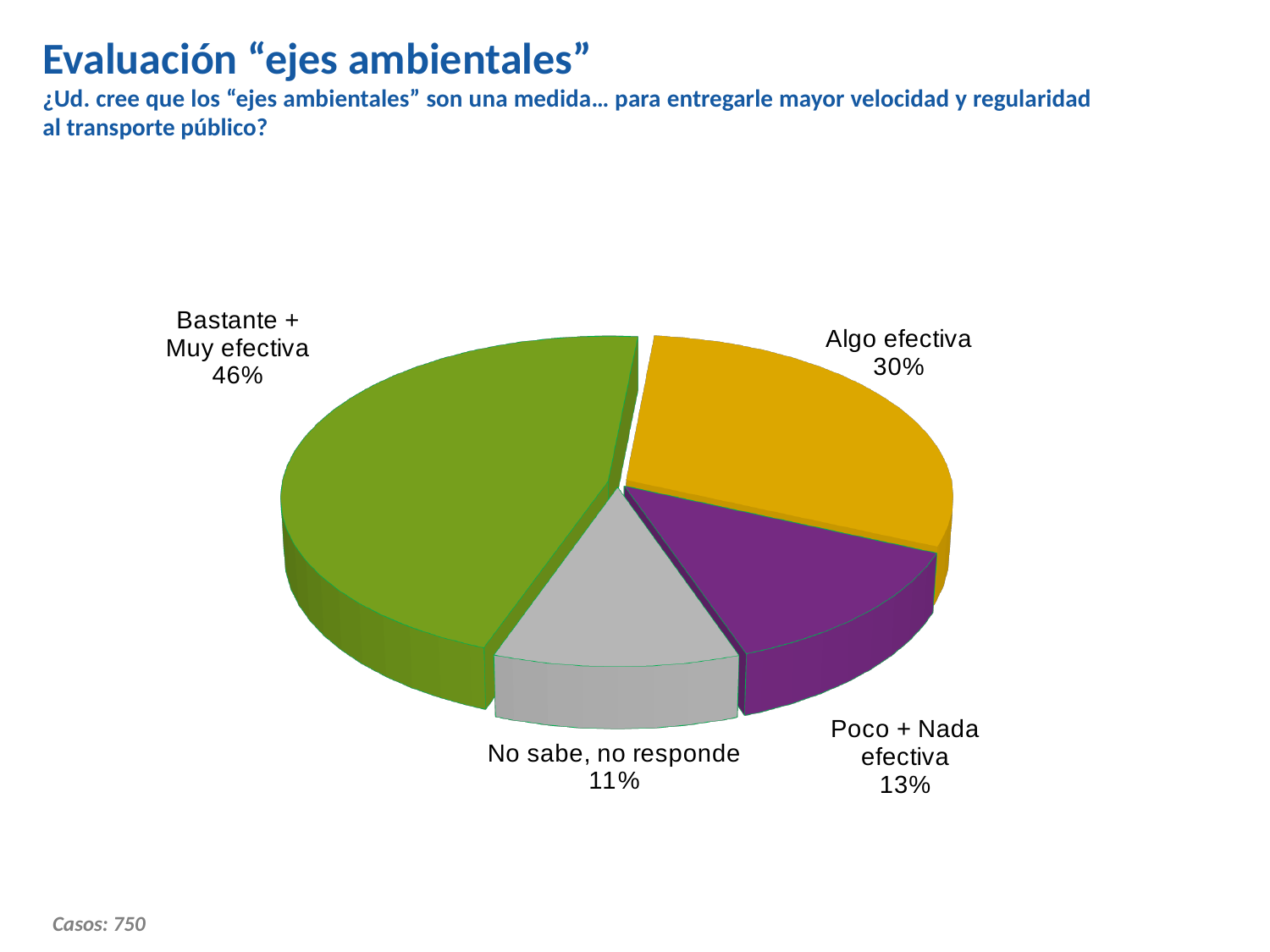
What percentage of respondents answered "Algo efectiva"? 30% What is the difference in percentage points between "Bastante + Muy efectiva" and "Algo efectiva"? 16 What percentage of respondents answered "No sabe, no responde"? 11% Which category has the largest share of the pie? Bastante + Muy efectiva How many cases (Casos) does the slide report for the survey? 750 What percentage of respondents answered "Poco + Nada efectiva"? 13% Which is larger: the share for "Poco + Nada efectiva" or the share for "No sabe, no responde"? Poco + Nada efectiva What percentage of respondents answered "Bastante + Muy efectiva"? 46% Which category has the smallest share of the pie? No sabe, no responde What kind of chart is shown on the slide? pie chart What colour is the "Algo efectiva" slice? yellow How many slices does the pie chart have? 4